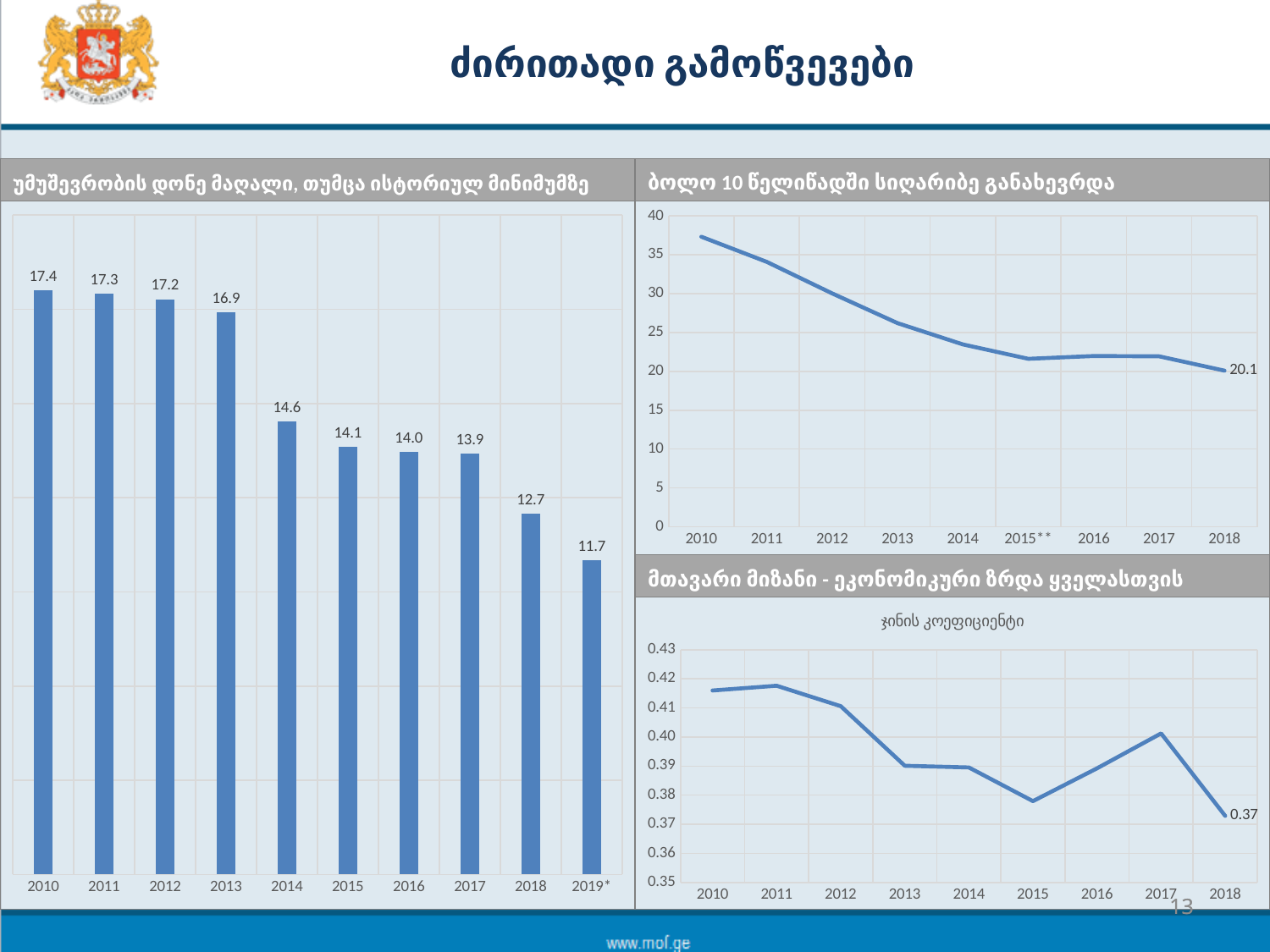
In the bar chart on the left, what is the value for 2010? 17.4 In the bar chart on the left, what is the value for 2019*? 11.7 In the bar chart on the left, do the values generally rise or fall from 2010 to 2019*? fall In the top-right line chart, is the value for 2010 greater or less than 35? greater In the top-right line chart, what is the value labelled for 2018? 20.1 In the bottom-right line chart, is the value for 2011 greater or less than 0.41? greater In the bar chart on the left, which year has the lowest value? 2019* In the bar chart on the left, which year has the highest value? 2010 What type of chart is shown on the left side of the slide? bar chart In the bar chart on the left, how many bars are plotted? 10 In the bar chart on the left, what is the difference between the values for 2013 and 2014? 2.3 In the bottom-right line chart, what is the value labelled for 2018? 0.37